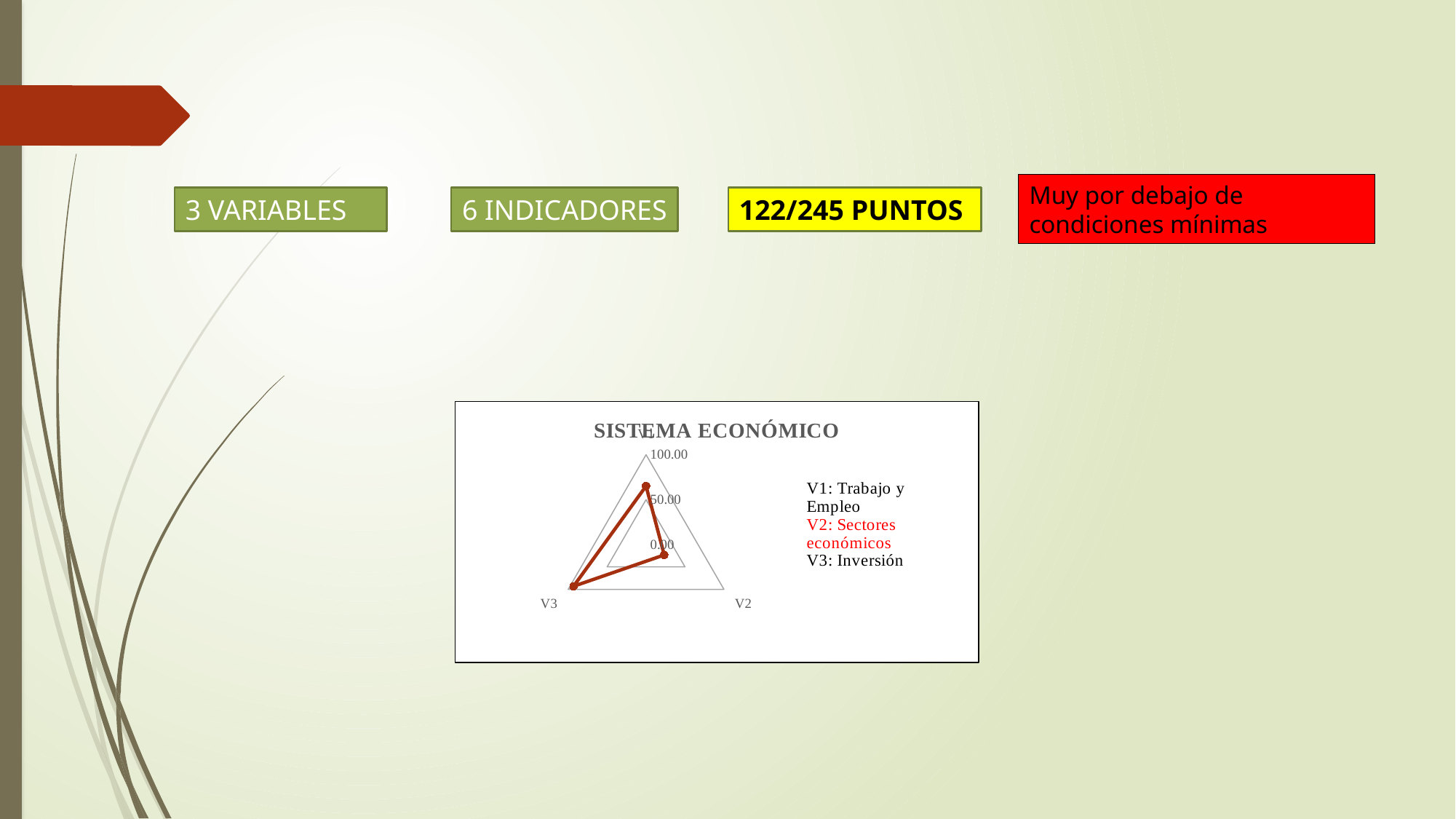
Is the value for V3 greater or less than 50.00? greater Which is larger, the value for V3 or the value for V1? V3 What is the title of the chart? SISTEMA ECONÓMICO Which is larger, the value for V1 or the value for V2? V1 Which category has the lowest value in the chart? V2 Is the value for V2 greater or less than 50.00? less What kind of chart is shown on the slide? Radar chart Which category has the highest value in the chart? V3 What is the maximum value shown on the chart's axis scale? 100.00 Is the value for V1 greater or less than 50.00? greater How many axes (categories) does the radar chart have? 3